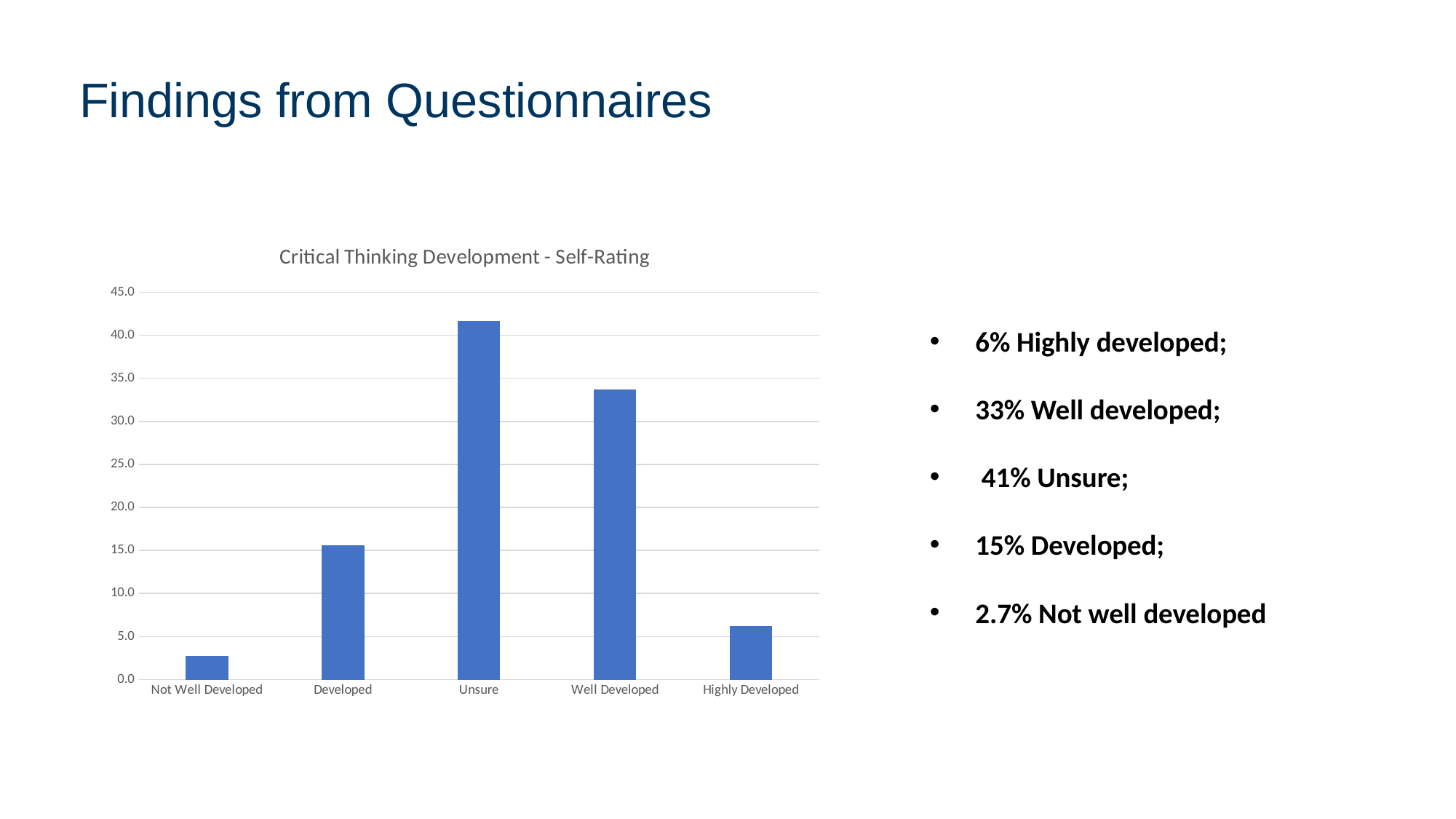
How many categories are shown on the x axis of the chart? 5 Which category has the lowest bar in the chart? Not Well Developed Is the value for Highly Developed greater or less than 10.0? less What type of chart is shown on the slide? bar chart Which category has the highest bar in the chart? Unsure Which is larger in the chart, the value for Well Developed or the value for Developed? Well Developed Is the value for Unsure greater or less than 40.0? greater Is the value for Well Developed greater or less than 35.0? less What is the title of the chart? Critical Thinking Development - Self-Rating Which is larger in the chart, the value for Highly Developed or the value for Not Well Developed? Highly Developed